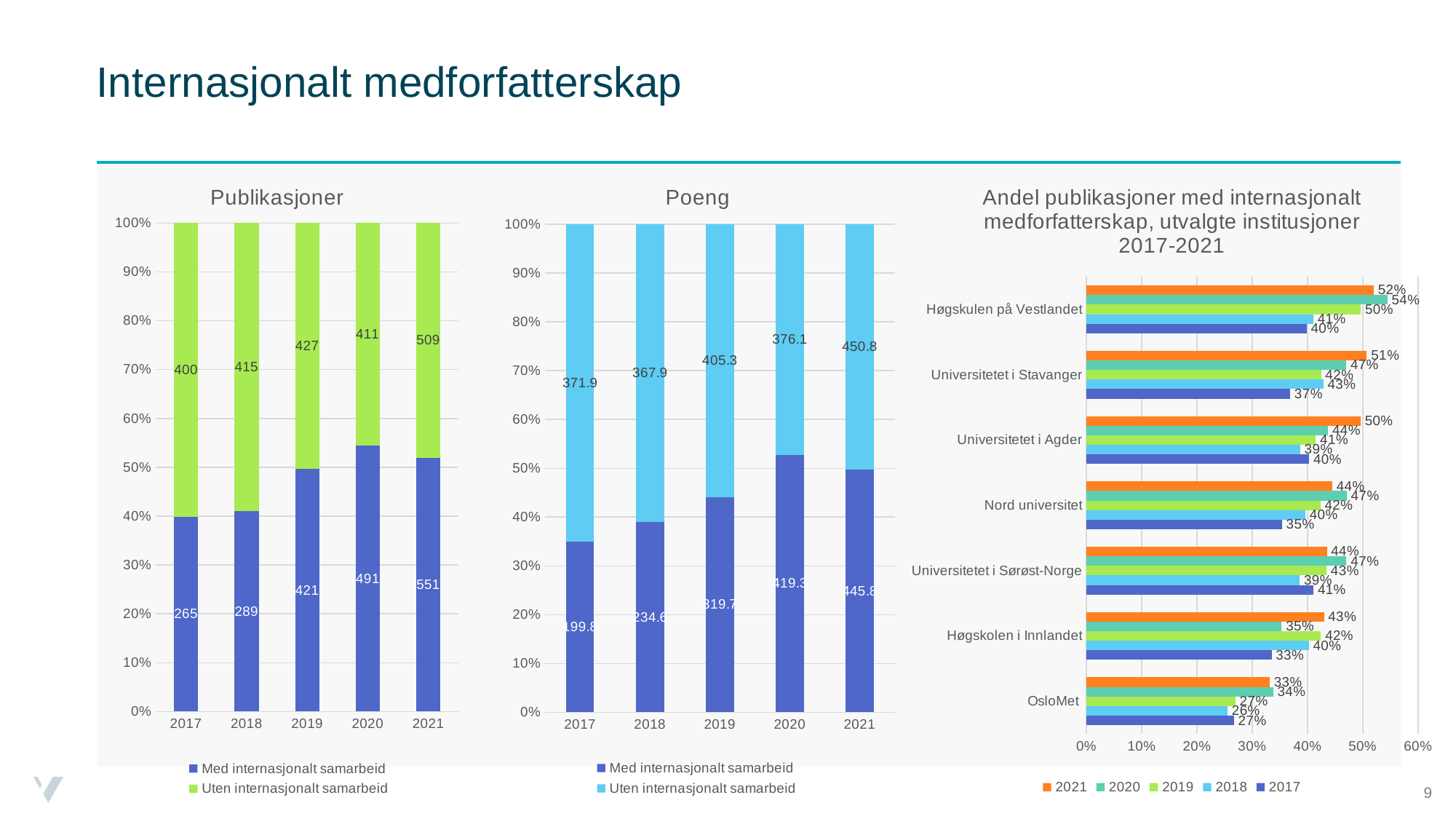
In the Poeng chart, what is the value for Uten internasjonalt samarbeid in 2020? 376.1 In the chart on the right (Andel publikasjoner med internasjonalt medforfatterskap), how many series does the legend list? 5 In the chart on the right (Andel publikasjoner med internasjonalt medforfatterskap), how many institutions are shown? 7 In the Publikasjoner chart, what is the total of the stacked bar for 2021? 1060 In the Publikasjoner chart, what is the difference between Med internasjonalt samarbeid in 2020 and 2019? 70 In the chart on the right (Andel publikasjoner med internasjonalt medforfatterskap), what is the value for Universitetet i Stavanger in 2021? 51% In the Publikasjoner chart, what is the value for Uten internasjonalt samarbeid in 2017? 400 In the Poeng chart, which year has the highest value for Med internasjonalt samarbeid? 2021 In the chart on the right (Andel publikasjoner med internasjonalt medforfatterskap), which institution has the lowest value in 2017? OsloMet In the Poeng chart, what is the value for Med internasjonalt samarbeid in 2019? 319.7 In the Poeng chart, does the Med internasjonalt samarbeid series rise or fall from 2017 to 2021? rise In the Publikasjoner chart, what is the value for Med internasjonalt samarbeid in 2021? 551